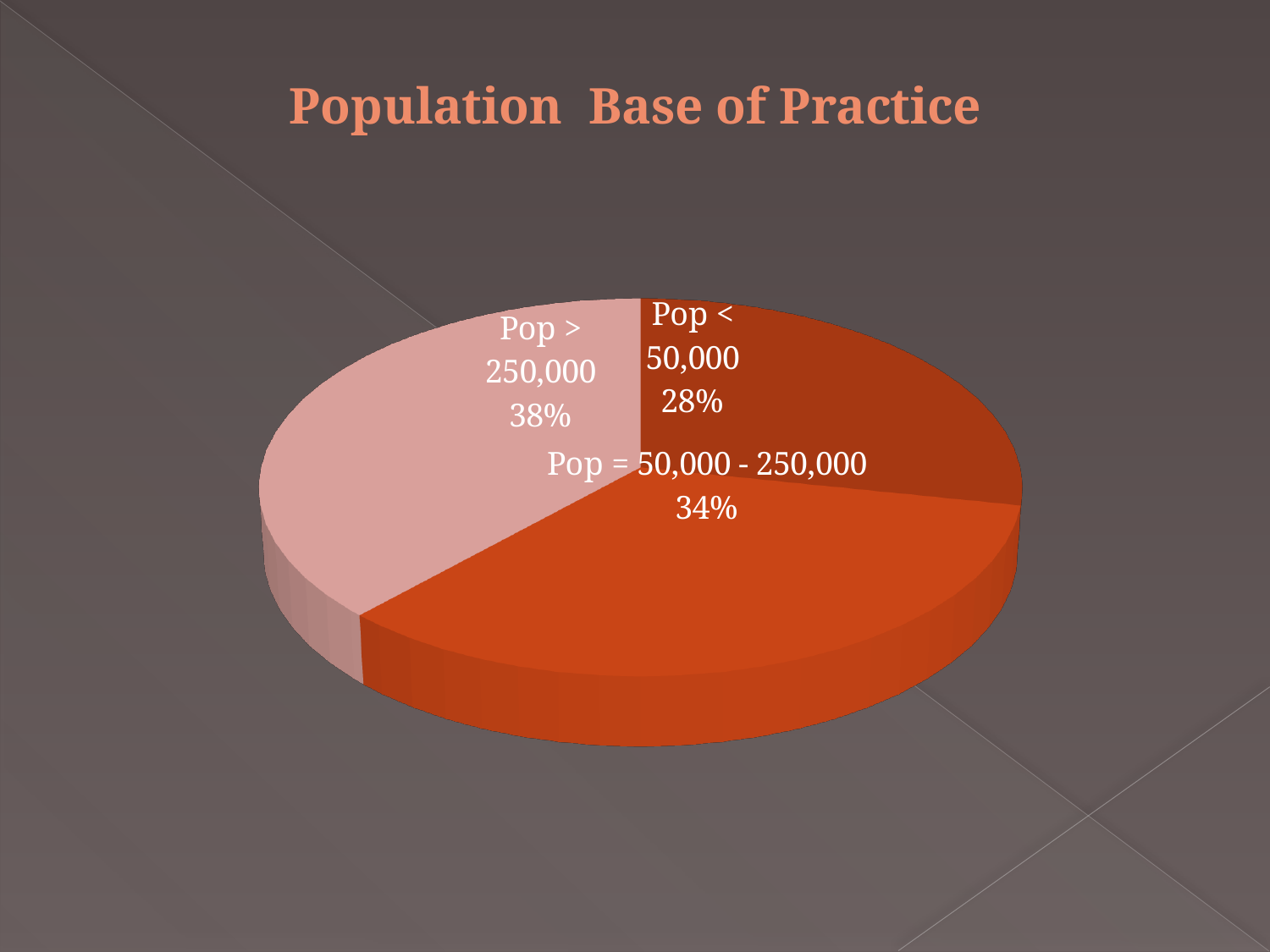
What type of chart is shown on the slide? pie chart What is the difference in percentage points between the Pop > 250,000 slice and the Pop = 50,000 - 250,000 slice? 4 How many slices does the pie chart have? 3 Which slice of the pie is shown in the lightest pink colour? Pop > 250,000 What share of the pie is labelled Pop > 250,000? 38% What share of the pie is labelled Pop = 50,000 - 250,000? 34% Which slice of the pie is the largest? Pop > 250,000 What is the difference in percentage points between the Pop > 250,000 slice and the Pop < 50,000 slice? 10 Which is larger, the Pop = 50,000 - 250,000 slice or the Pop < 50,000 slice? Pop = 50,000 - 250,000 Which slice of the pie is the smallest? Pop < 50,000 What is the title of the chart? Population Base of Practice What share of the pie is labelled Pop < 50,000? 28%